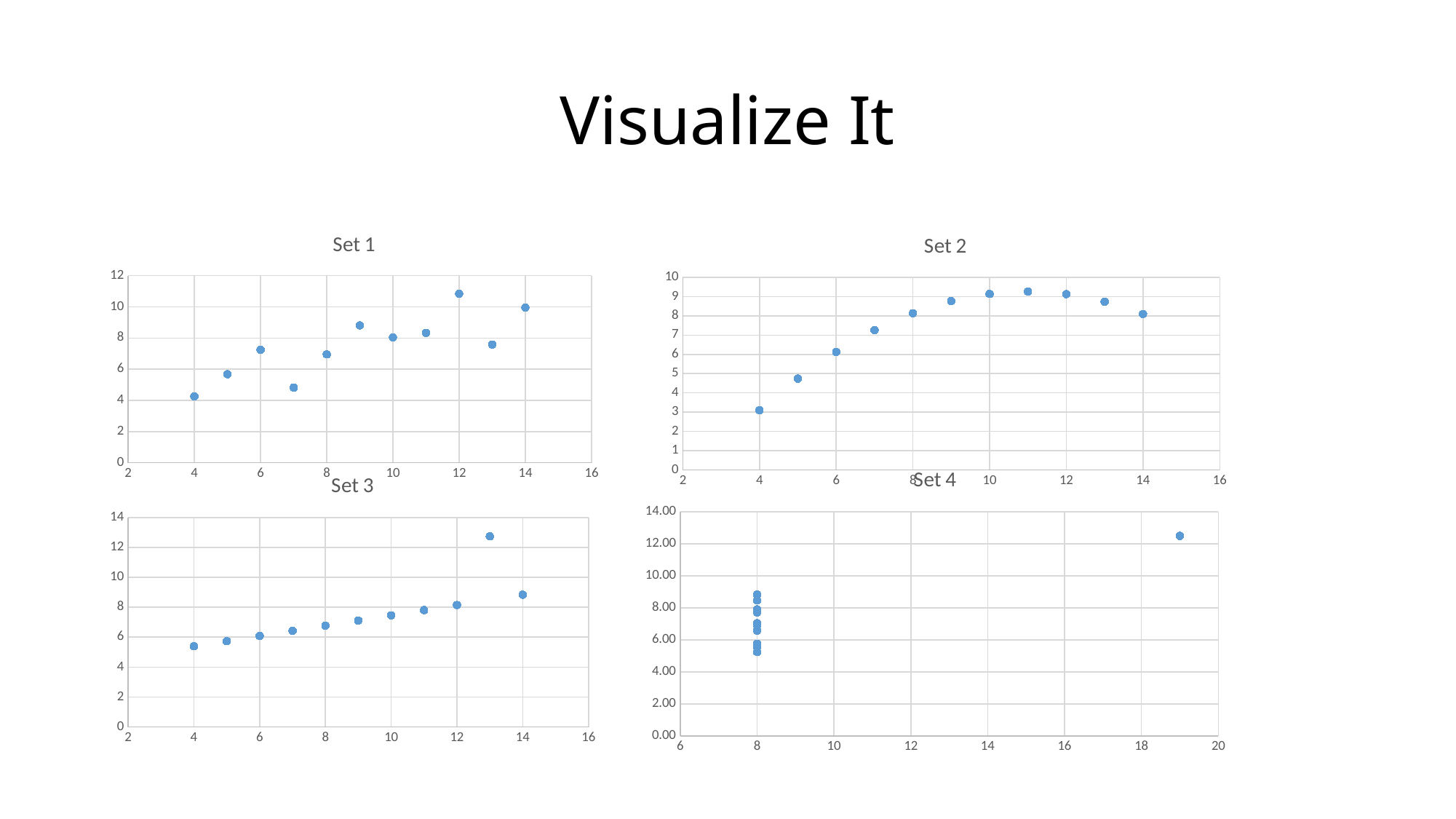
In the Set 4 chart, is the value at x = 19 greater or less than 12.00? greater In the Set 1 chart, at which x value is the highest point? 12 How many charts are shown on the slide? 4 In the Set 2 chart, at which x value is the highest point? 11 In the Set 1 chart, is the value at x = 12 greater or less than 10? greater In the Set 2 chart, at which x value is the lowest point? 4 In the Set 1 chart, is the value at x = 7 greater or less than 6? less In the Set 3 chart, at which x value is the lowest point? 4 What kind of chart is the Set 1 chart? scatter chart In the Set 1 chart, how many data points are plotted? 11